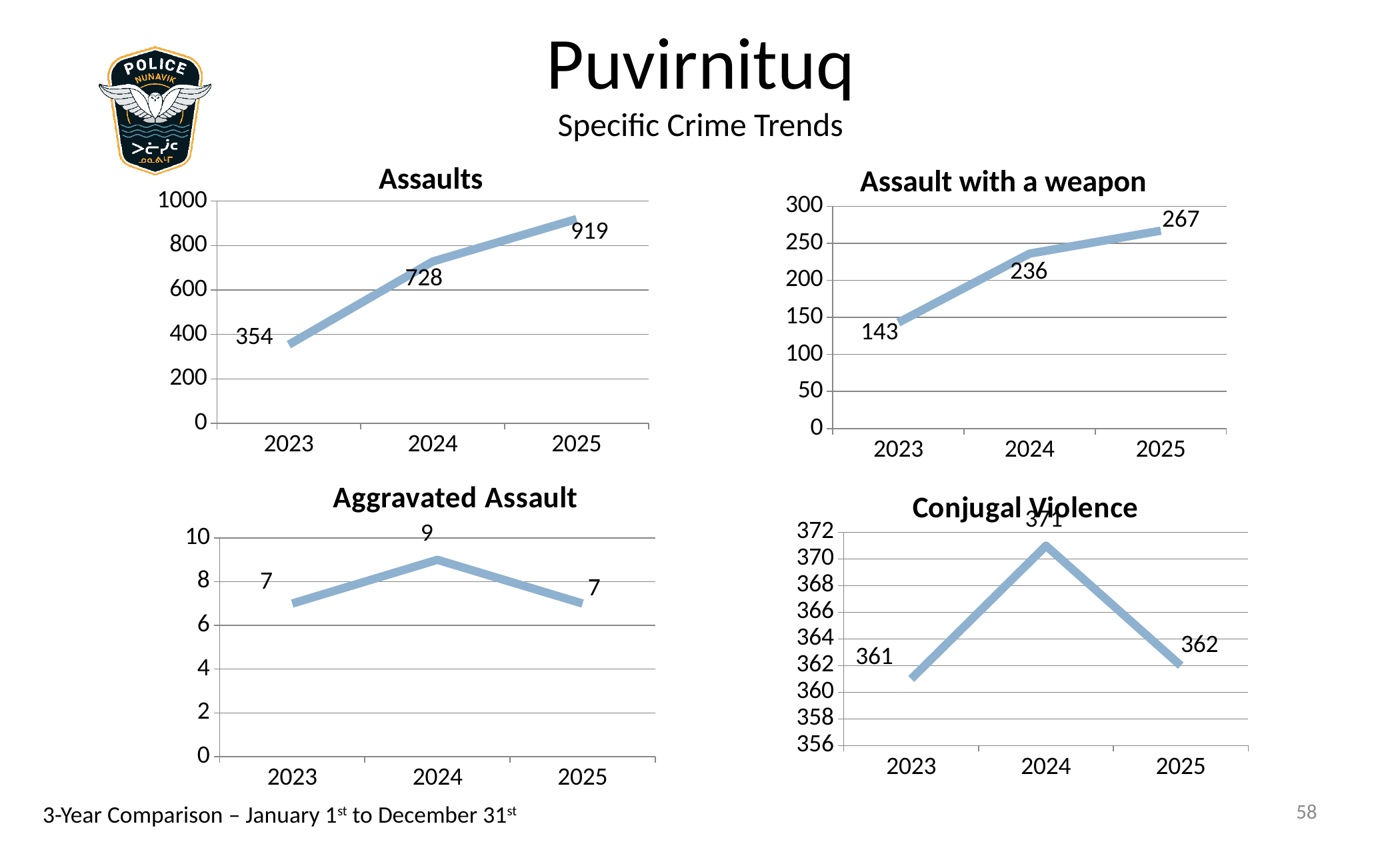
In the Assaults chart, what is the value for 2025? 919 In the Assaults chart, which year has the lowest value? 2023 In the Assaults chart, what is the difference between the 2024 and 2023 values? 374 What kind of chart is the Assaults chart? line chart In the Conjugal Violence chart, what is the value for 2024? 371 In the Aggravated Assault chart, what is the value for 2023? 7 In the Assault with a weapon chart, do the values rise or fall from 2023 to 2025? rise In the Assault with a weapon chart, what is the value for 2024? 236 How many data points are plotted in the Conjugal Violence chart? 3 In the Conjugal Violence chart, which is larger, the value for 2023 or the value for 2025? 2025 In the Aggravated Assault chart, which year has the highest value? 2024 In the Assault with a weapon chart, what is the difference between the 2025 and 2023 values? 124